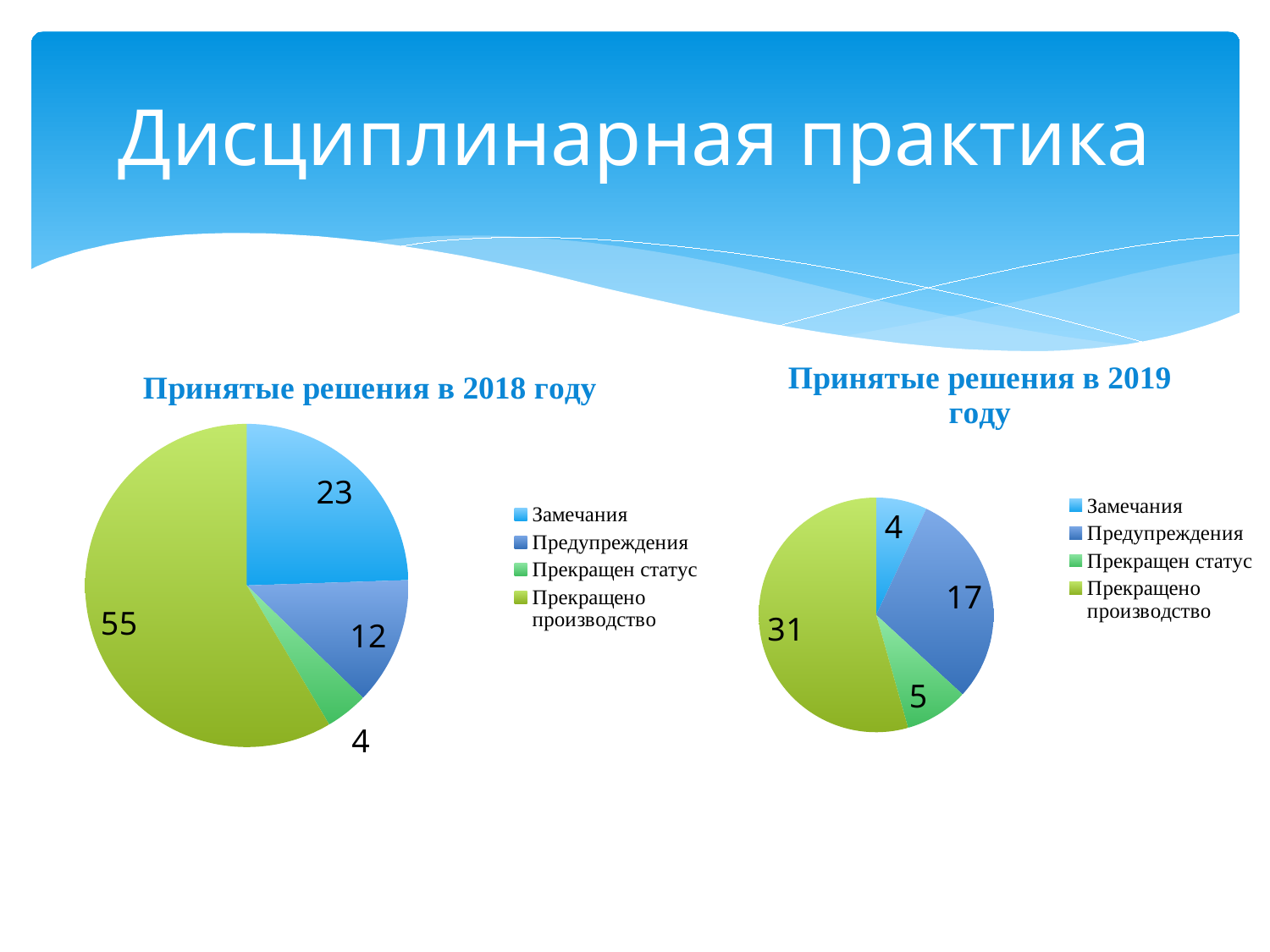
In the chart 'Принятые решения в 2019 году', what is the difference between Прекращено производство and Предупреждения? 14 How many slices does the chart 'Принятые решения в 2018 году' have? 4 In the chart 'Принятые решения в 2019 году', what is the value for Предупреждения? 17 In the chart 'Принятые решения в 2018 году', what is the difference between Прекращено производство and Замечания? 32 In the chart 'Принятые решения в 2018 году', what is the value for Замечания? 23 What is the total of all slices in the chart 'Принятые решения в 2018 году'? 94 In the chart 'Принятые решения в 2018 году', which category has the largest value? Прекращено производство Which is larger: Замечания in the 2018 chart or Замечания in the 2019 chart? 2018 In the chart 'Принятые решения в 2019 году', which is larger, Предупреждения or Прекращен статус? Предупреждения In the chart 'Принятые решения в 2019 году', which category has the smallest value? Замечания What is the total of all slices in the chart 'Принятые решения в 2019 году'? 57 What type of chart is 'Принятые решения в 2019 году'? Pie chart